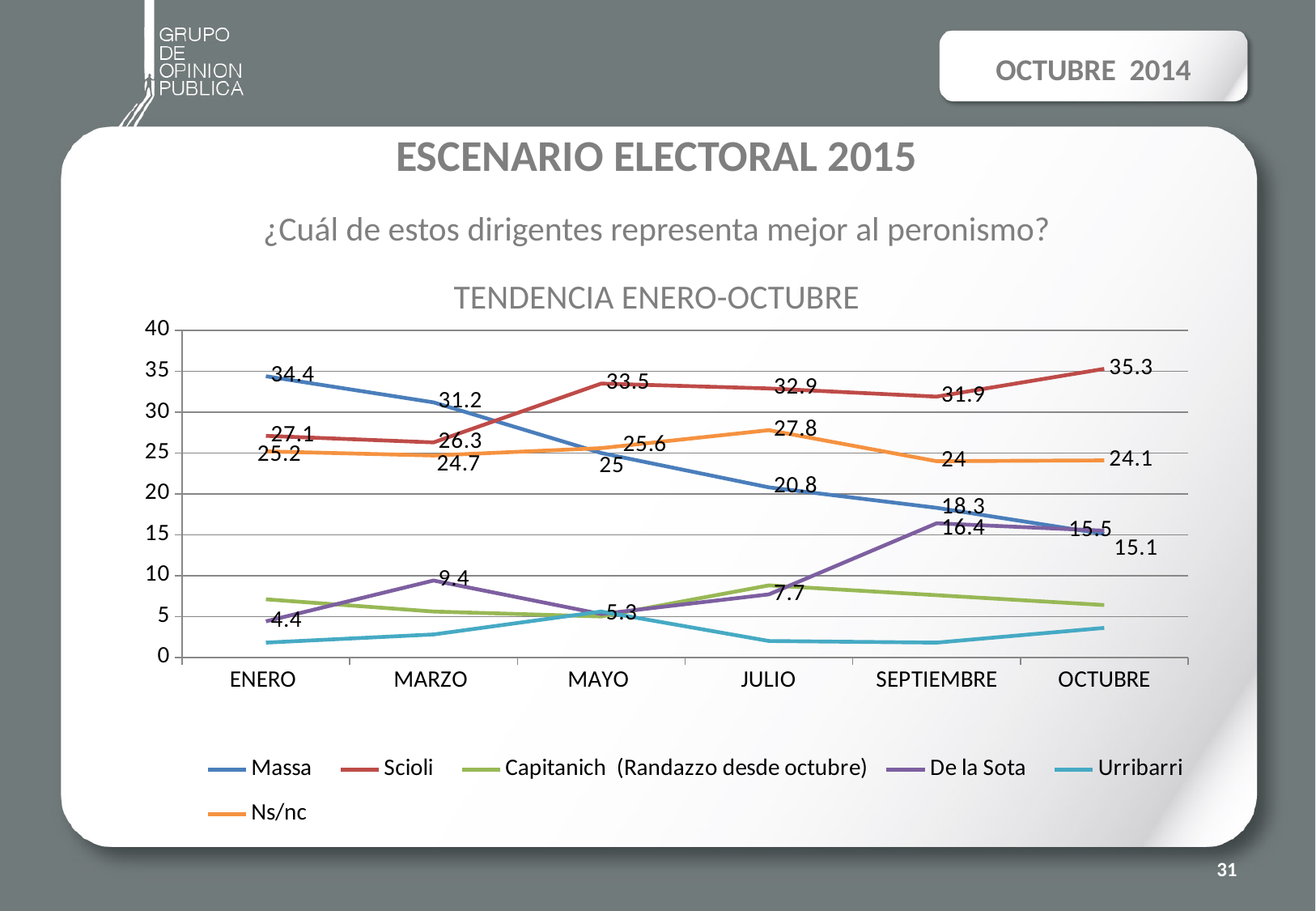
How many months are shown along the x axis? 6 What is the difference between Massa and Scioli in ENERO? 7.3 What is the value for Massa in ENERO? 34.4 Is the value for Urribarri in JULIO greater or less than 5? less What is the value for Ns/nc in JULIO? 27.8 In which month does Scioli reach its highest value? OCTUBRE Does the value for Massa rise or fall from ENERO to OCTUBRE? fall How many series does the legend list? 6 What is the value for Scioli in OCTUBRE? 35.3 What is the value for De la Sota in SEPTIEMBRE? 16.4 In MAYO, which is larger: Scioli or Massa? Scioli What kind of chart is shown on the slide? line chart